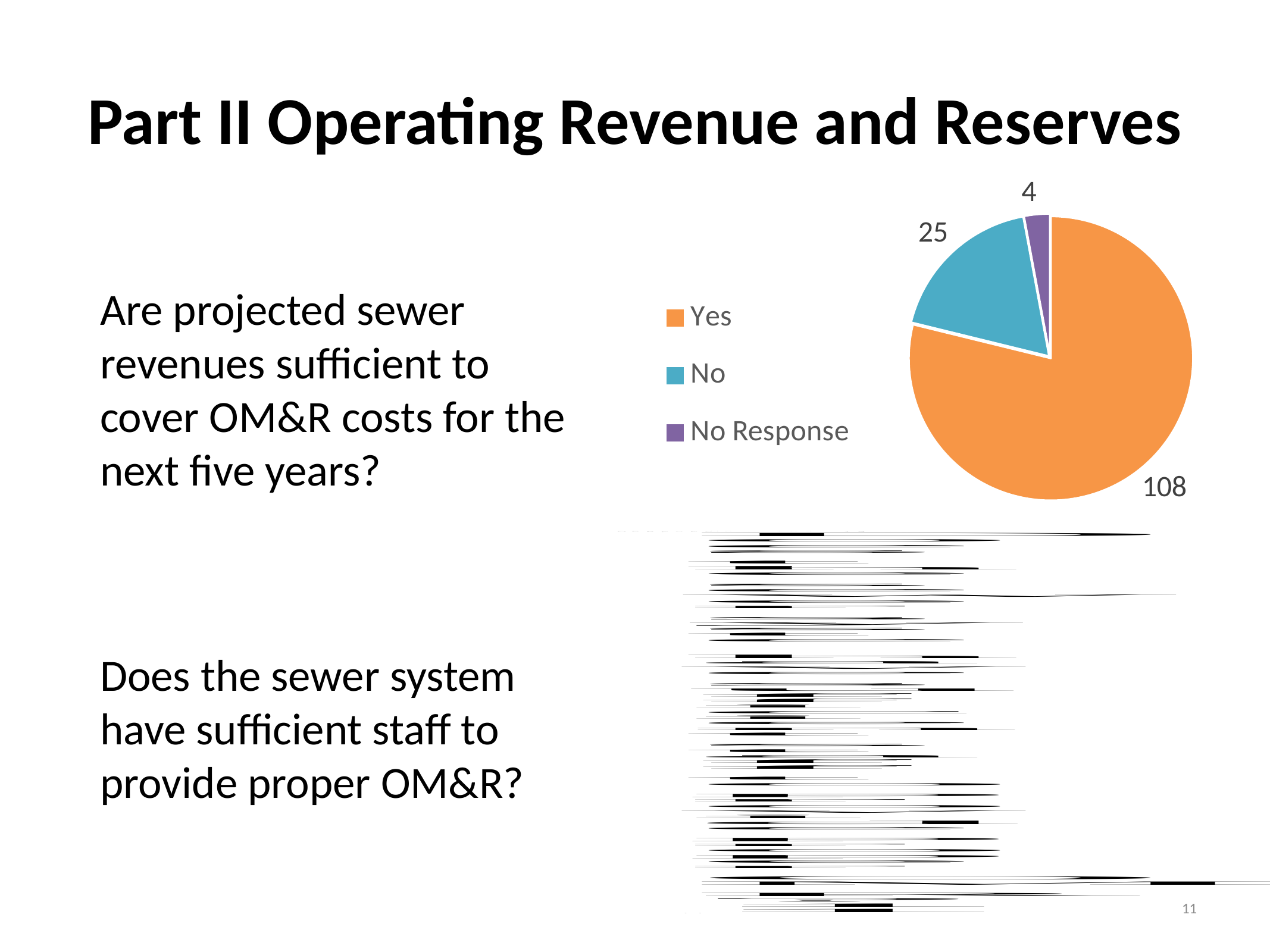
In the pie chart at the top right, what is the difference between the No and No Response counts? 21 In the pie chart at the top right, which category has the largest slice? Yes In the pie chart at the top right, what is the total of all three slices? 137 In the pie chart at the top right, how many respondents answered Yes? 108 In the pie chart at the top right, which colour represents the No category? Blue In the pie chart at the top right, which is larger, the No slice or the No Response slice? No How many categories does the pie chart at the top right show? 3 In the pie chart at the top right, what is the value for No Response? 4 In the pie chart at the top right, how many respondents answered No? 25 In the pie chart at the top right, what is the difference between the Yes and No counts? 83 In the pie chart at the top right, which category has the smallest slice? No Response What type of chart is shown at the top right of the slide? Pie chart